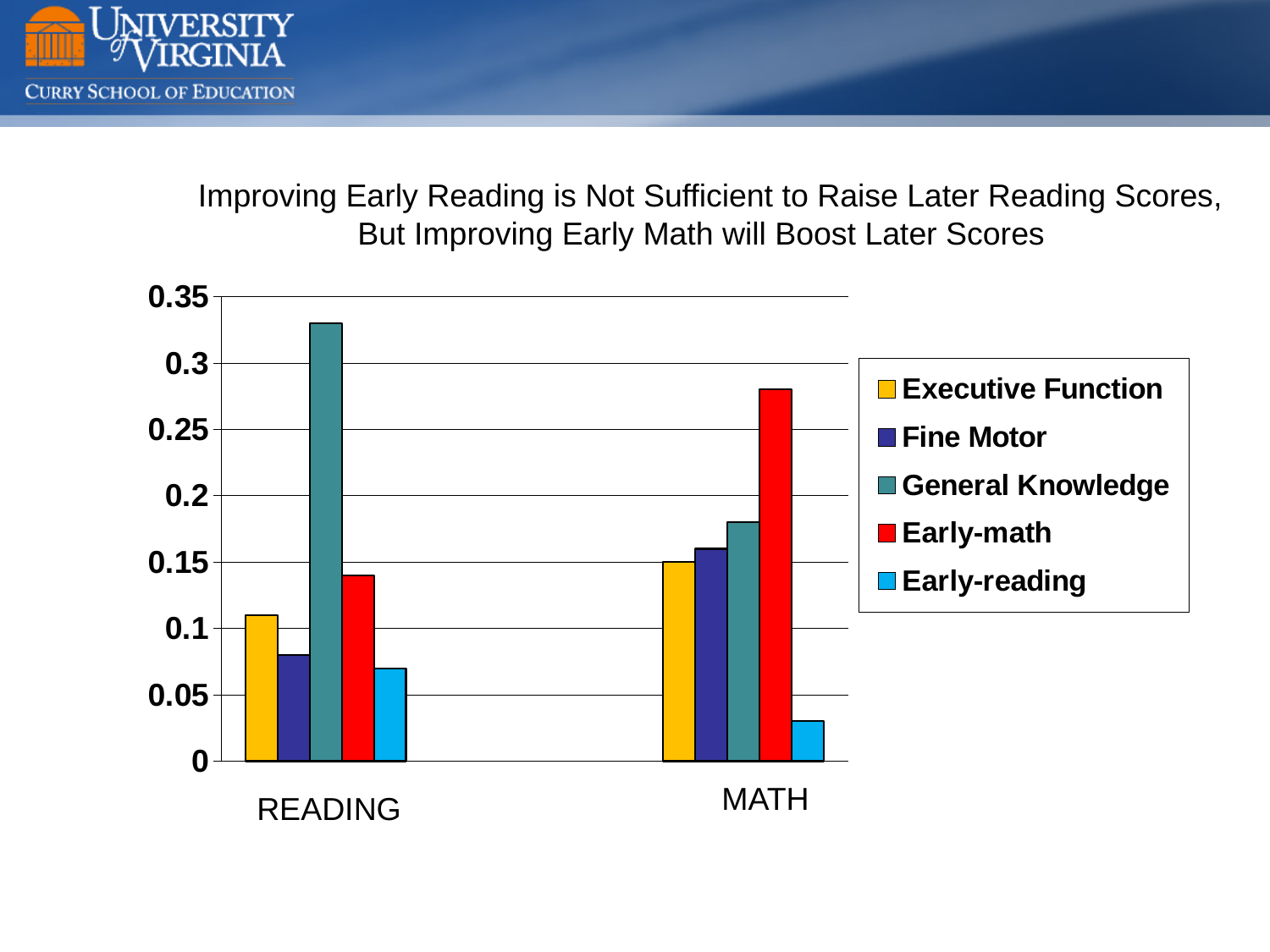
Is the value for General Knowledge in READING greater or less than 0.3? greater Which series has the highest value for READING? General Knowledge What kind of chart is shown on the slide? bar chart How many series does the legend list? 5 Is the value for Fine Motor in READING greater or less than 0.1? less Which series has the lowest value for MATH? Early-reading Is the value for Early-math in MATH greater or less than 0.25? greater Which is larger: the Early-math value for READING or the Early-math value for MATH? MATH What colour are the Early-math bars? red Which series has the highest value for MATH? Early-math How many categories are shown on the x axis? 2